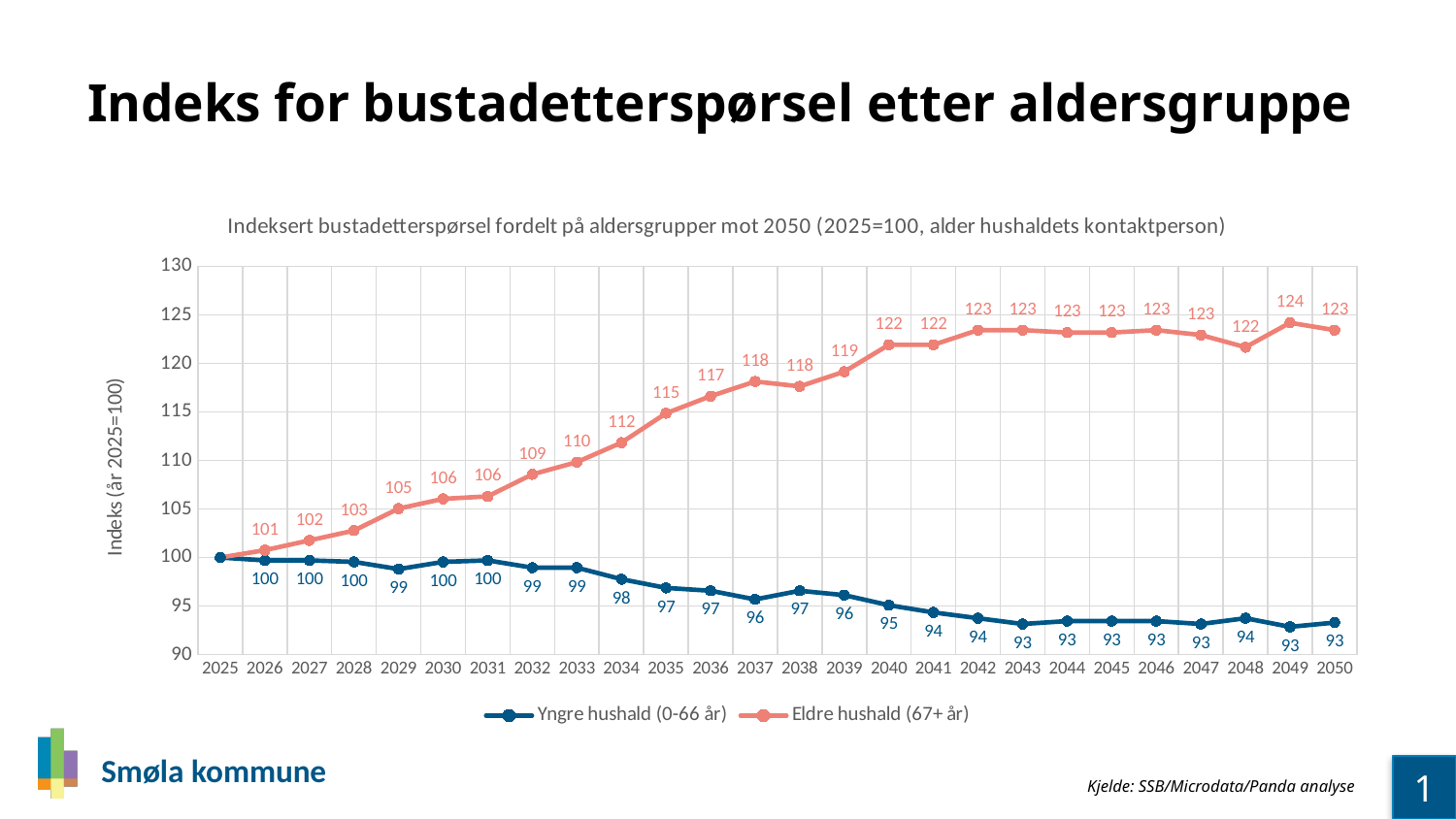
What is the value for Eldre hushald (67+ år) in 2040? 122 Does the Yngre hushald (0-66 år) series generally rise or fall from 2025 to 2050? fall Is the value for Eldre hushald (67+ år) in 2033 greater or less than 105? greater What is the value for Yngre hushald (0-66 år) in 2034? 98 What is the value for Eldre hushald (67+ år) in 2035? 115 Which series has the higher value in 2045, Yngre hushald (0-66 år) or Eldre hushald (67+ år)? Eldre hushald (67+ år) In which year does Eldre hushald (67+ år) reach its highest value? 2049 What is the difference between Eldre hushald (67+ år) and Yngre hushald (0-66 år) in 2050? 30 What is the label of the y axis? Indeks (år 2025=100) How many series does the legend list? 2 How many years are plotted along the x axis? 26 What type of chart is shown on the slide? line chart